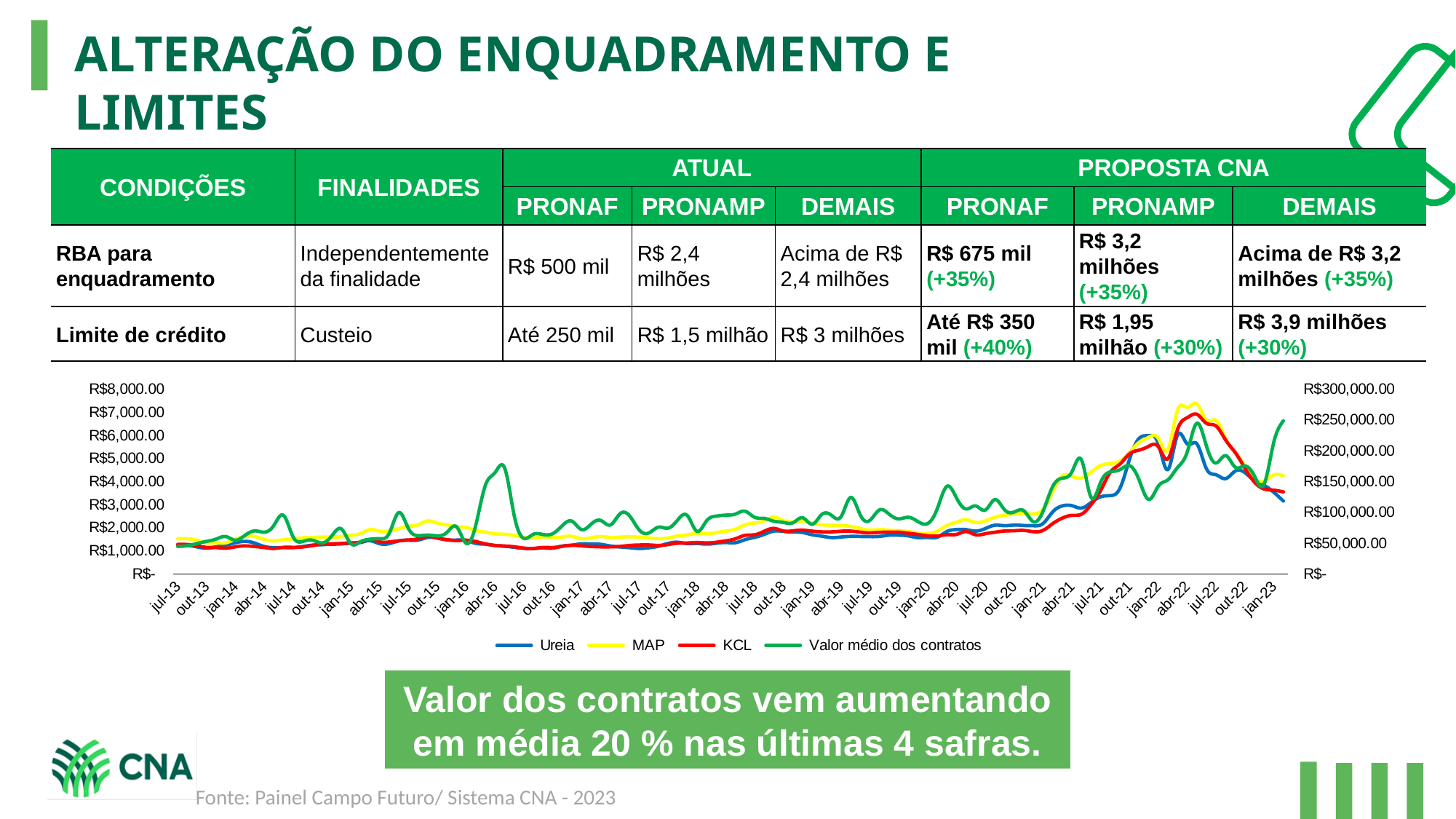
Which series are listed in the chart legend? Ureia, MAP, KCL, Valor médio dos contratos Does the Valor médio dos contratos line rise or fall overall from jul-13 to jan-23? Rise What is the highest tick value on the chart's right y axis? R$300,000.00 What colour is the KCL line in the chart? Red What is the first label on the chart's x axis? jul-13 What is the highest tick value on the chart's left y axis? R$8,000.00 How many series does the chart legend list? 4 What is the last label on the chart's x axis? jan-23 How many labels are shown on the chart's x axis? 39 What kind of chart is shown on the slide? Line chart Which line reaches the highest point in the chart's plot area? MAP